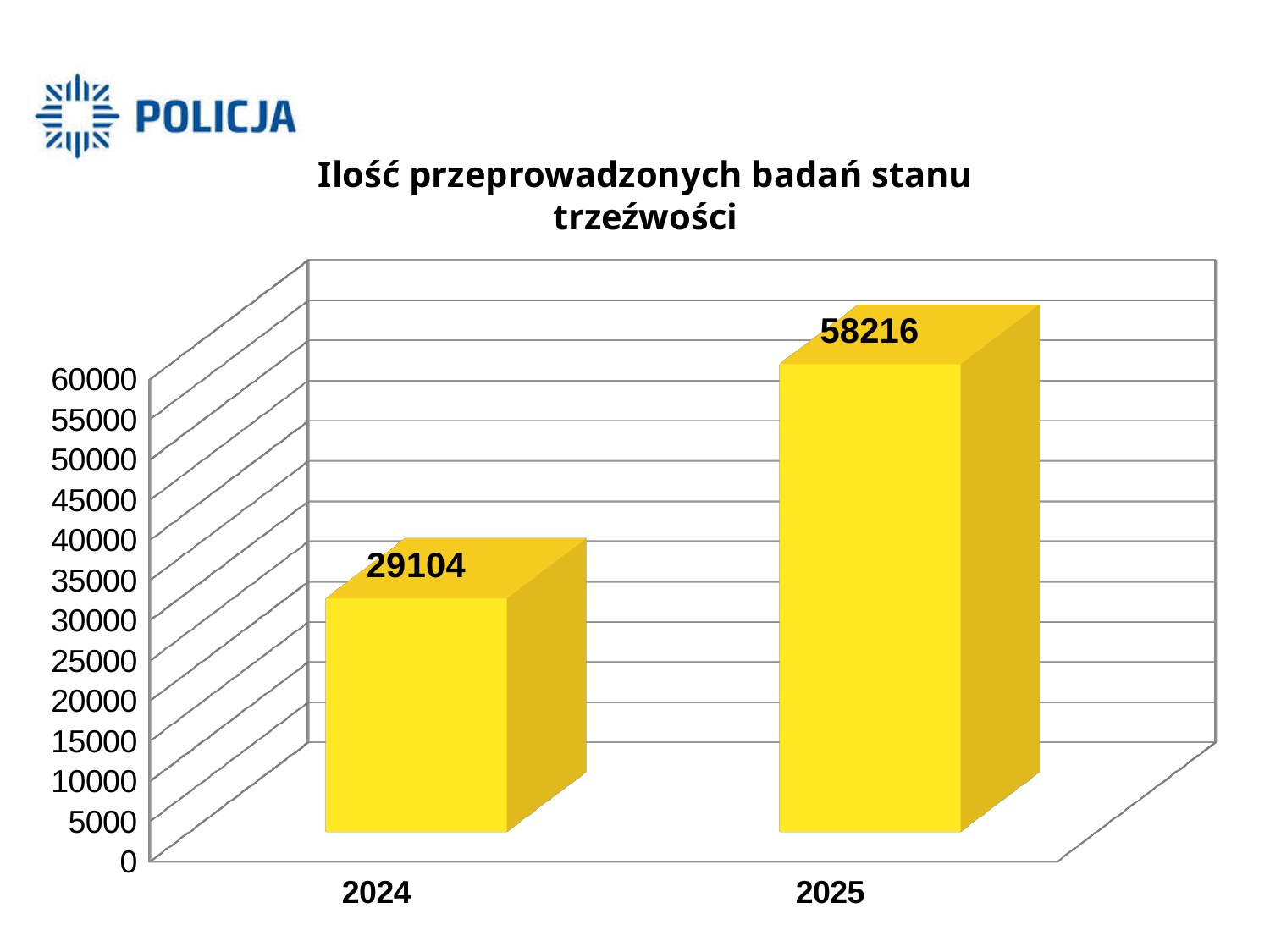
What is the value for 2024? 29104 What is the difference between the values for 2025 and 2024? 29112 Which is larger, the value for 2024 or the value for 2025? 2025 Is the value for 2025 greater or less than 60000? less What is the title of the chart? Ilość przeprowadzonych badań stanu trzeźwości Which year has the lowest value? 2024 Is the value for 2024 greater or less than 25000? greater Do the values rise or fall from 2024 to 2025? rise Which year has the highest value? 2025 What is the value for 2025? 58216 How many categories are shown on the x axis? 2 What kind of chart is shown on the slide? bar chart